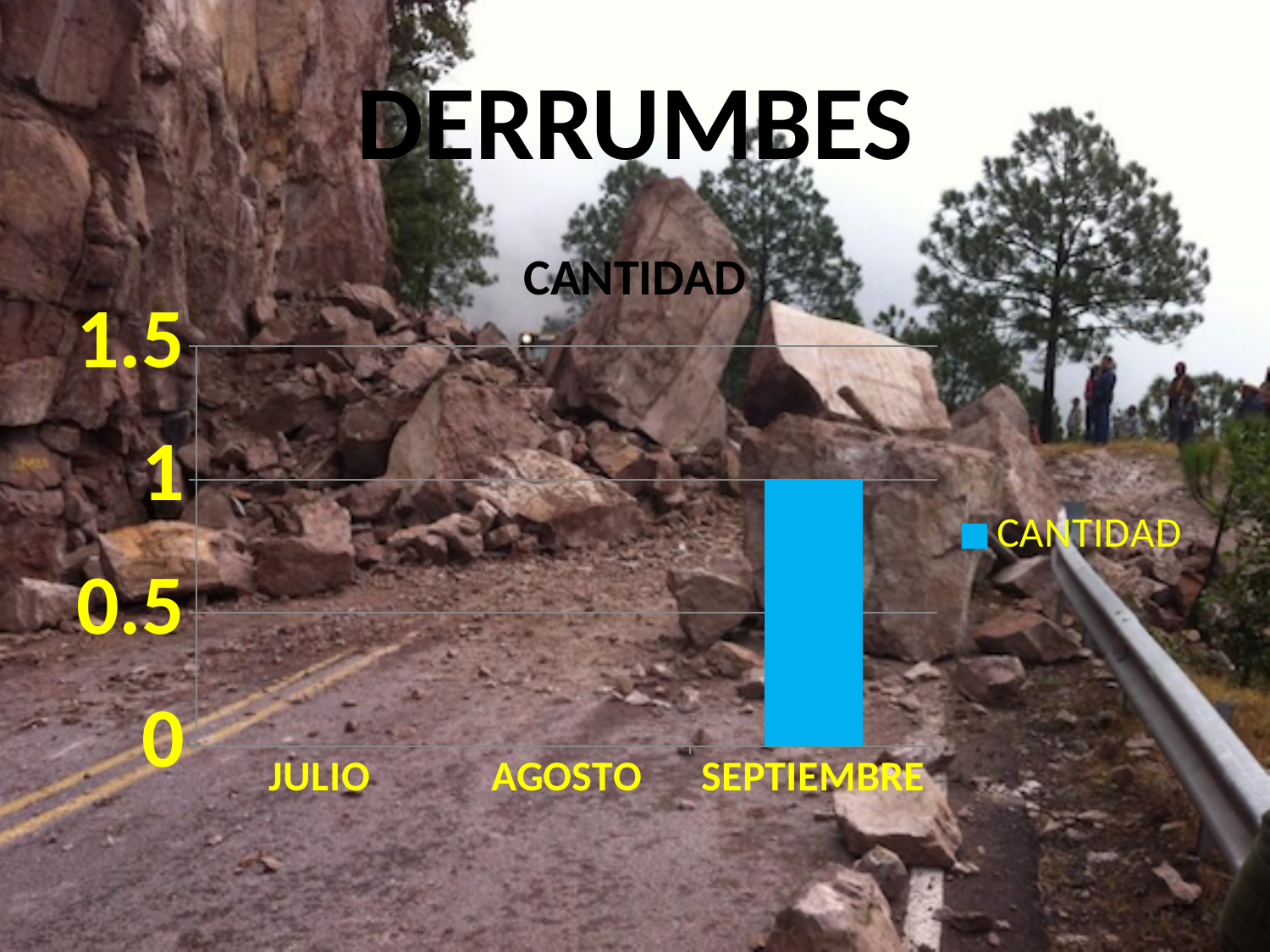
Which category has the highest value in the chart? SEPTIEMBRE What is the highest value shown on the y axis of the chart? 1.5 How many series does the chart legend list? 1 What is the name of the series shown in the chart legend? CANTIDAD Is the value for SEPTIEMBRE greater or less than 0.5? greater How many categories are shown on the x axis of the chart? 3 What is the title of the chart? CANTIDAD What is the value for SEPTIEMBRE in the chart? 1 Is the value for SEPTIEMBRE greater or less than 1.5? less What type of chart is shown on the slide? bar chart Which is larger, the value for AGOSTO or the value for SEPTIEMBRE? SEPTIEMBRE